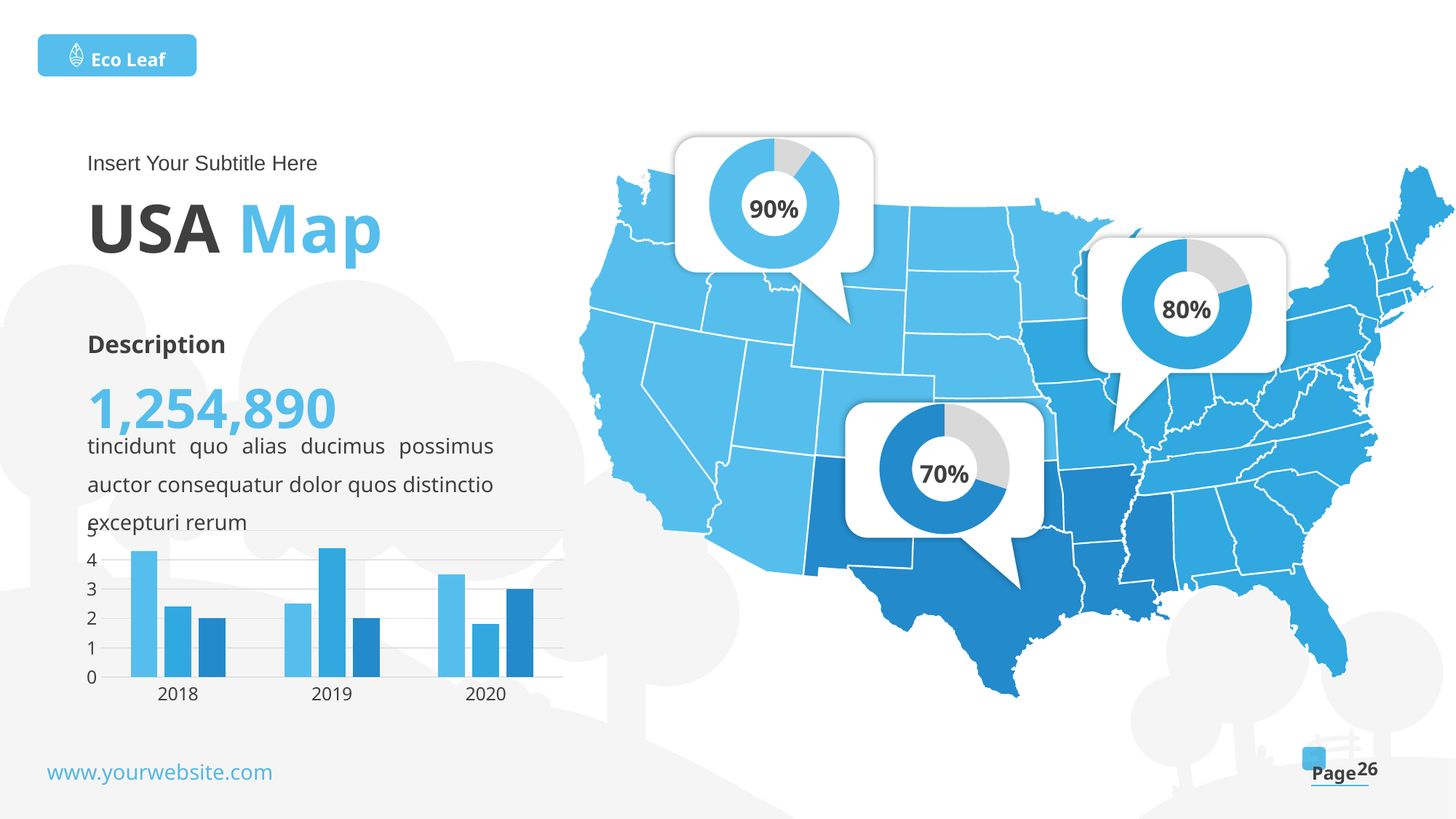
In the bar chart at the bottom left, is the value of the lightest blue bar for 2018 greater or less than 4? greater In the bar chart at the bottom left, is the value of the middle (medium blue) bar for 2019 greater or less than 4? greater Of the three donut charts on the map, which shows the lowest percentage? 70% In the bar chart at the bottom left, which of the three bars for 2019 is the tallest? the middle (medium blue) bar In the bar chart at the bottom left, how many bars are plotted for each year? 3 In the bar chart at the bottom left, is the value of the middle (medium blue) bar for 2020 greater or less than 2? less In the bar chart at the bottom left, how many years are shown on the x axis? 3 What percentage is shown in the donut chart at the top left of the map, over the northwestern states? 90% What percentage is shown in the donut chart positioned over Texas at the bottom of the map? 70% What kind of chart is shown at the bottom left of the slide, below the description text? bar chart In the bar chart at the bottom left, is the lightest blue bar larger for 2018 or for 2019? 2018